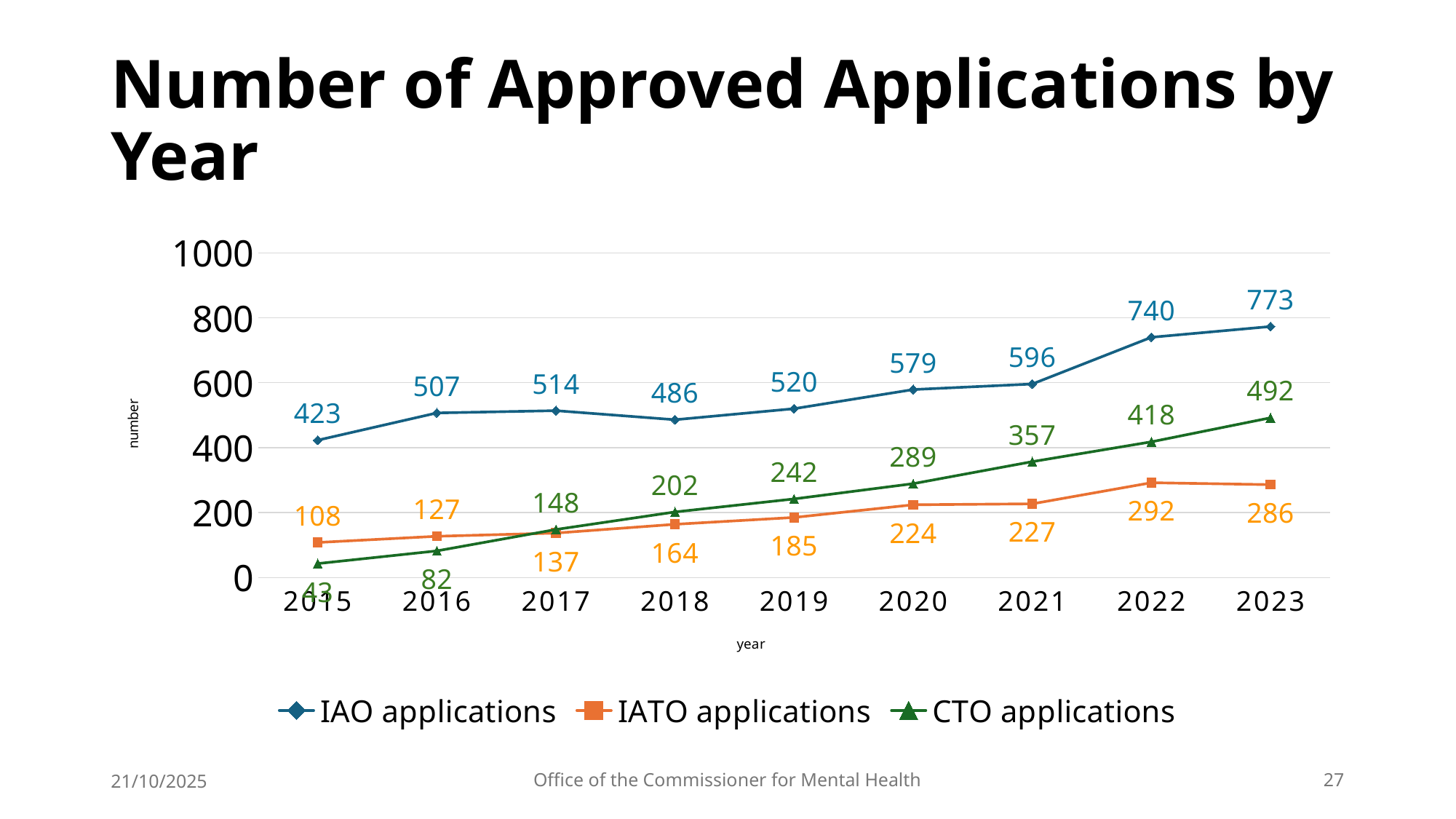
Do CTO applications rise or fall from 2015 to 2023? rise Which is larger in 2017: IATO applications or CTO applications? CTO applications How many series does the legend list? 3 What is the value for CTO applications in 2021? 357 In which year were CTO applications highest? 2023 What type of chart is shown on the slide? line chart What is the title of the chart? Number of Approved Applications by Year What is the value for IATO applications in 2019? 185 What is the difference between IAO applications in 2023 and 2022? 33 What is the value for IAO applications in 2023? 773 In which year were IAO applications lowest? 2015 How many years are plotted on the x axis? 9